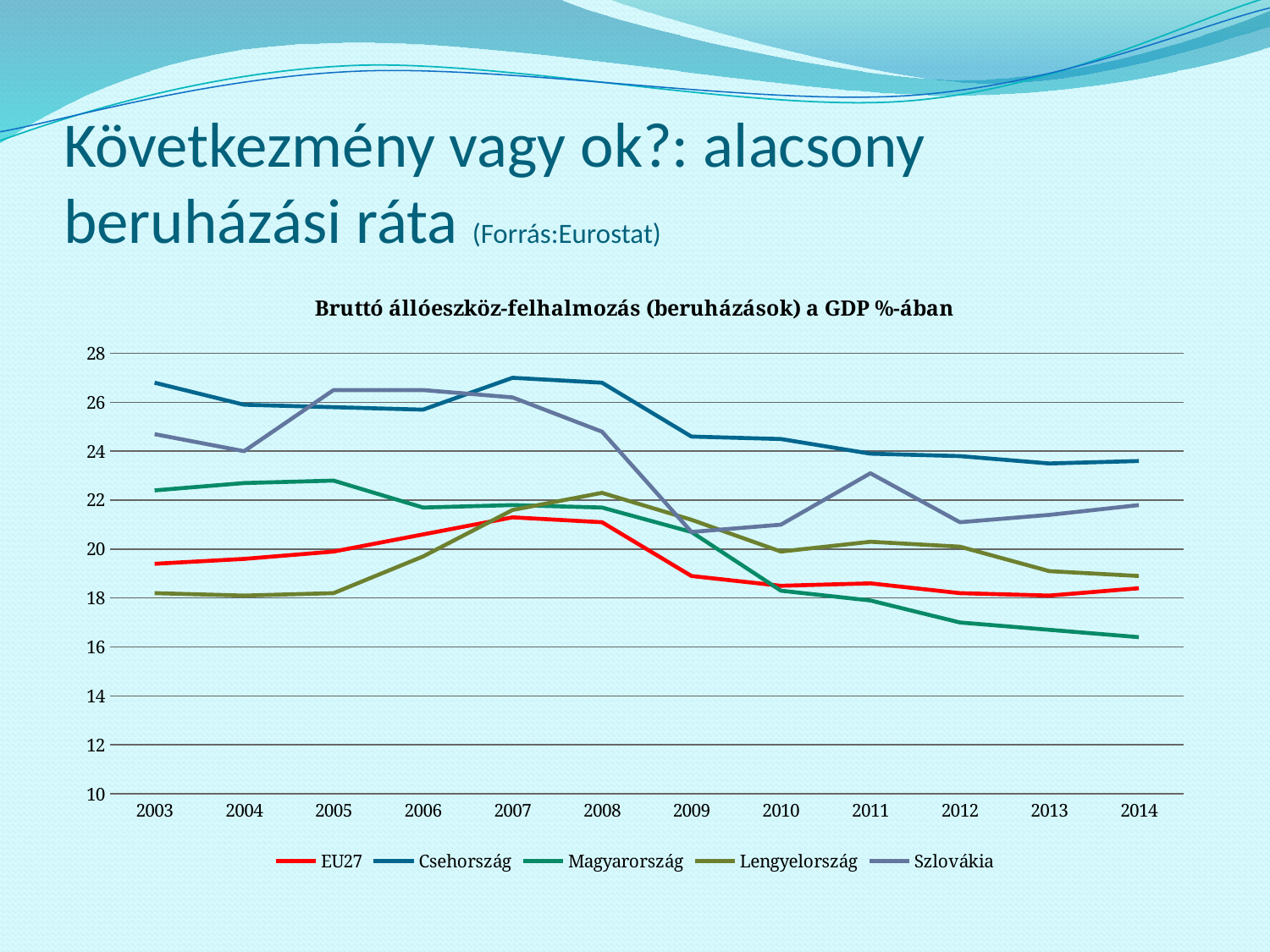
How many series does the legend list? 5 Is the value for Magyarország in 2014 greater or less than 18? less Which series has the lowest value in 2014? Magyarország Is the value for Csehország in 2007 greater or less than 26? greater Which series has the highest value in 2003? Csehország What colour is the EU27 line? red Which series has the lowest value in 2003? Lengyelország In 2014, which is larger: the value for Csehország or for Magyarország? Csehország What is the title of the chart? Bruttó állóeszköz-felhalmozás (beruházások) a GDP %-ában Is the value for Szlovákia in 2011 greater or less than 22? greater How many years are shown on the x axis? 12 What kind of chart is shown on the slide? line chart